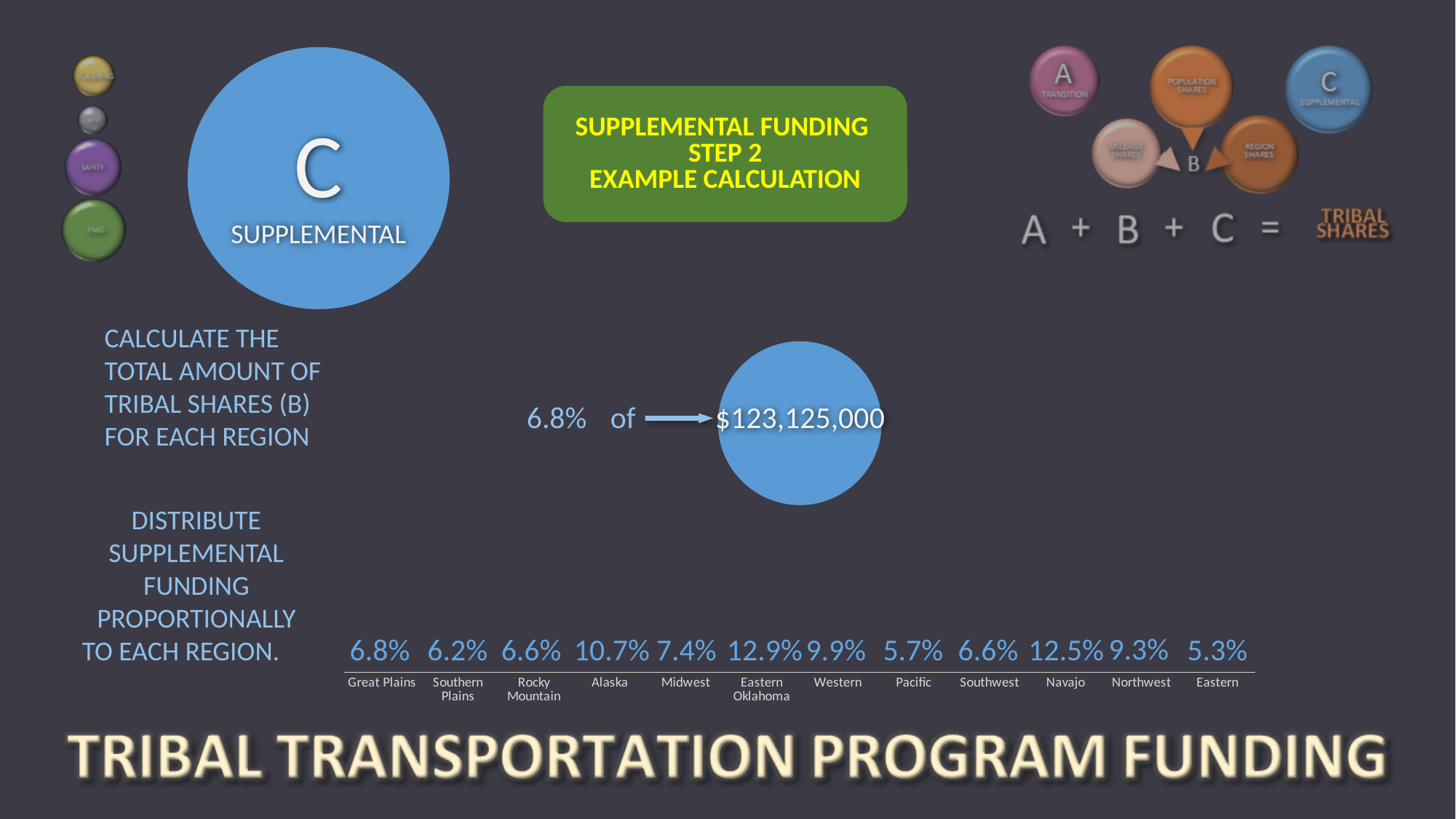
What is the value shown for Pacific in the regional percentage chart? 5.7% What dollar amount is shown in the blue circle that the 6.8% is applied to? $123,125,000 What is the value shown for Great Plains in the regional percentage chart? 6.8% Which region has the lowest percentage in the regional percentage chart? Eastern What is the value shown for Navajo in the regional percentage chart? 12.5% In the regional percentage chart, which is larger, the value for Western or the value for Northwest? Western What is the value shown for Alaska in the regional percentage chart? 10.7% How many regions are listed in the regional percentage chart? 12 What is the difference between the Alaska and Midwest values in the regional percentage chart? 3.3% Which region has the highest percentage in the regional percentage chart? Eastern Oklahoma What is the difference between the Eastern Oklahoma and Navajo values in the regional percentage chart? 0.4% What is the value shown for Eastern Oklahoma in the regional percentage chart? 12.9%